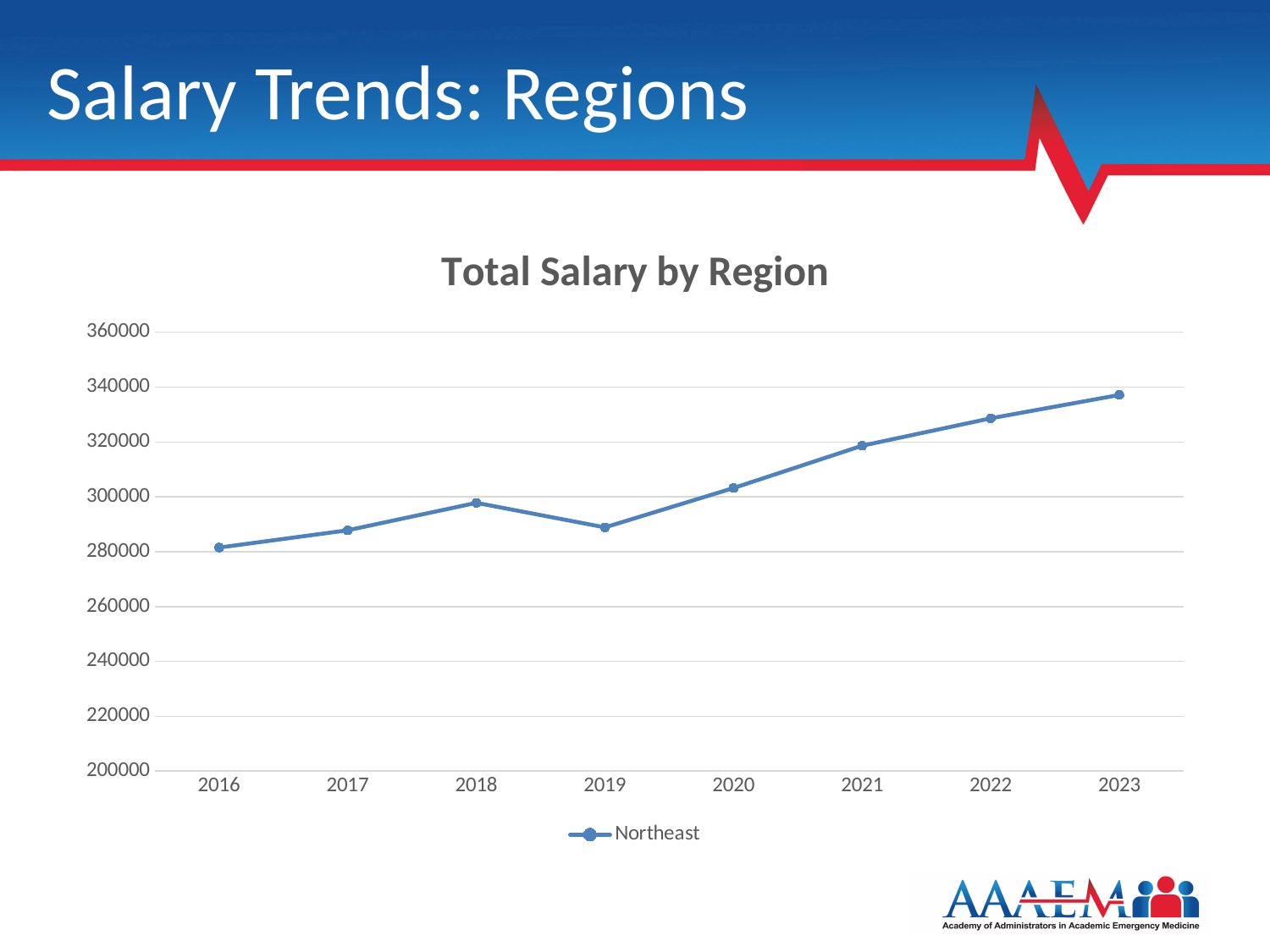
Do the Northeast values generally rise or fall from 2016 to 2023? rise Which year has the larger Northeast value, 2018 or 2019? 2018 What kind of chart is shown on the slide? line chart What is the title of the chart? Total Salary by Region Which region is plotted in the chart? Northeast Is the Northeast value for 2019 greater or less than 300000? less Is the Northeast value for 2016 greater or less than 300000? less In which year is the Northeast total salary highest? 2023 In which year is the Northeast total salary lowest? 2016 How many years are plotted along the x axis? 8 How many series does the legend list? 1 Is the Northeast value for 2023 greater or less than 320000? greater